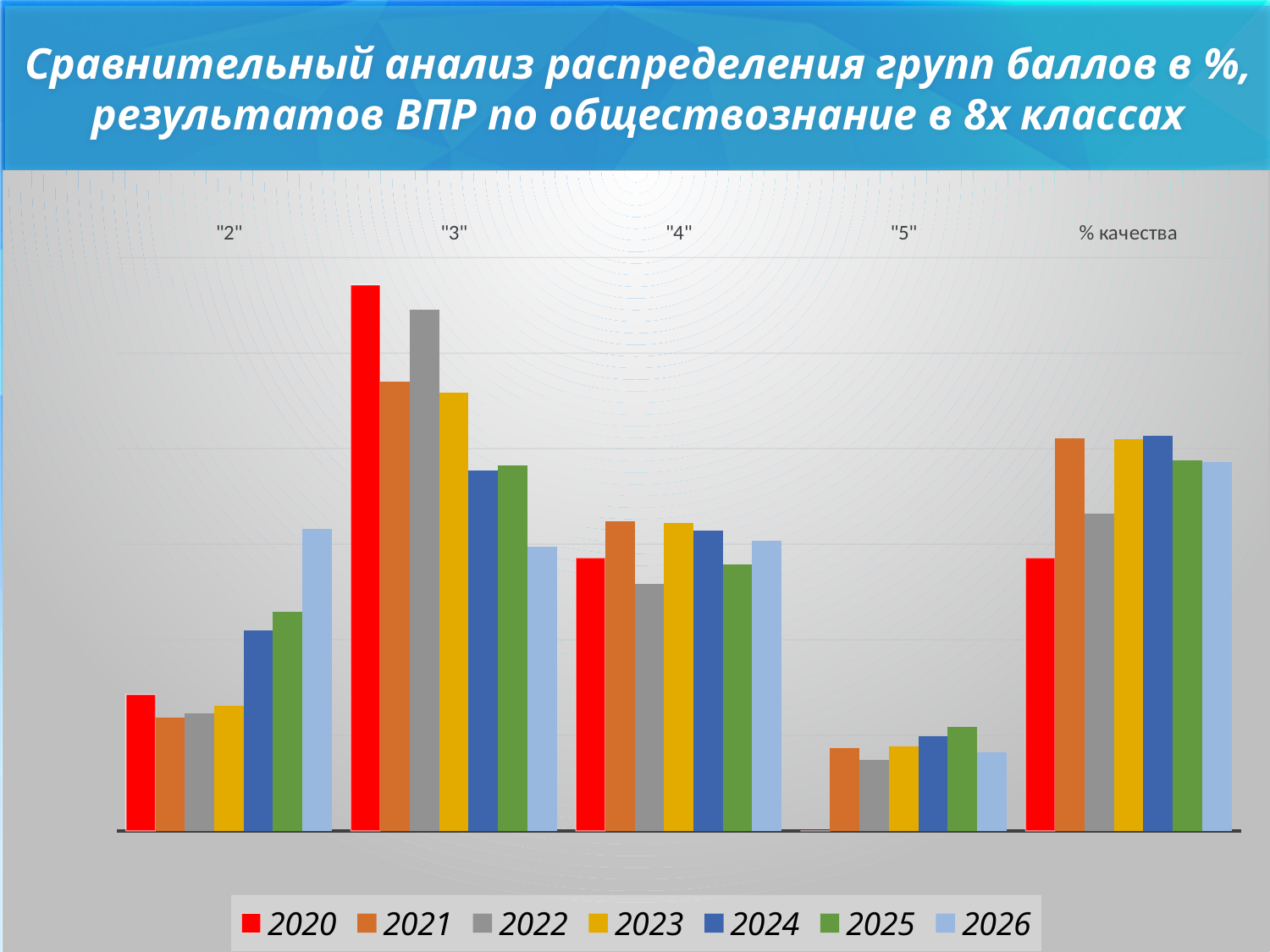
Which year has the highest bar in the "3" category? 2020 What kind of chart is shown on the slide? bar chart Which year has the lowest bar in the "3" category? 2026 How many categories are shown along the x axis of the chart? 5 In the "3" category, which is larger: the value for 2021 or the value for 2022? 2022 Which series is shown in red in the legend? 2020 How many series does the legend list? 7 Which year has the lowest bar in the "% качества" category? 2020 Which year has the highest bar in the "5" category? 2025 Which year has the highest bar in the "2" category? 2026 Which year has the lowest bar in the "4" category? 2022 In the "2" category, which is larger: the value for 2024 or the value for 2025? 2025